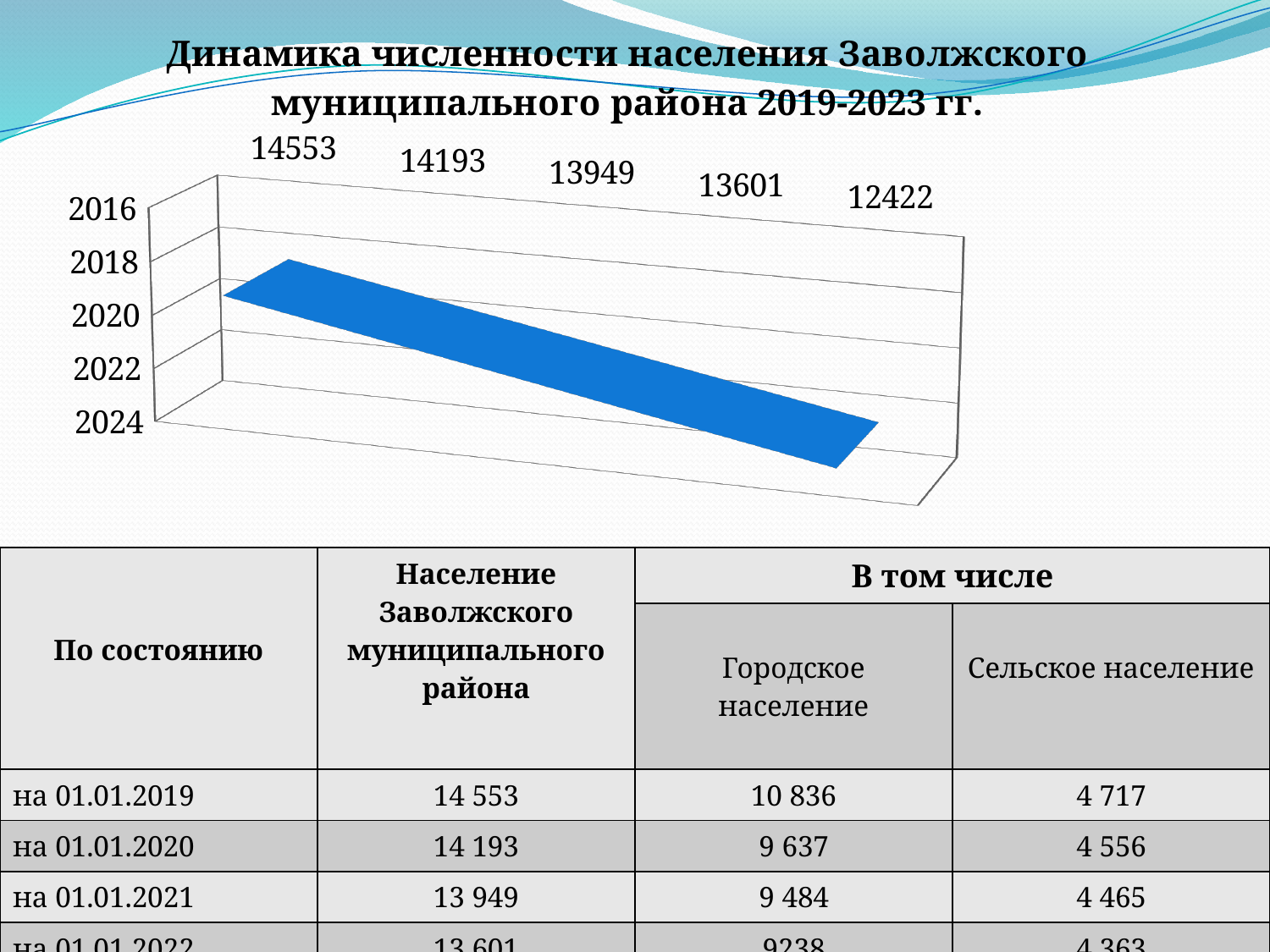
What is the first data label shown on the chart (for 2019)? 14553 Do the values on the chart rise or fall from the first point to the last? fall Which is larger on the chart: the second data label (14193) or the fourth data label (13601)? 14193 What is the title of the chart on the slide? Динамика численности населения Заволжского муниципального района 2019-2023 гг. What is the last data label shown on the chart (for 2023)? 12422 What is the lowest value labelled on the chart? 12422 What kind of chart is shown on the slide? line chart (3D) How many data labels are printed on the chart? 5 What is the highest value labelled on the chart? 14553 What is the difference between the data labels 13601 and 12422 on the chart? 1179 What is the difference between the first data label (14553) and the last data label (12422) on the chart? 2131 What is the third data label shown on the chart (for 2021)? 13949